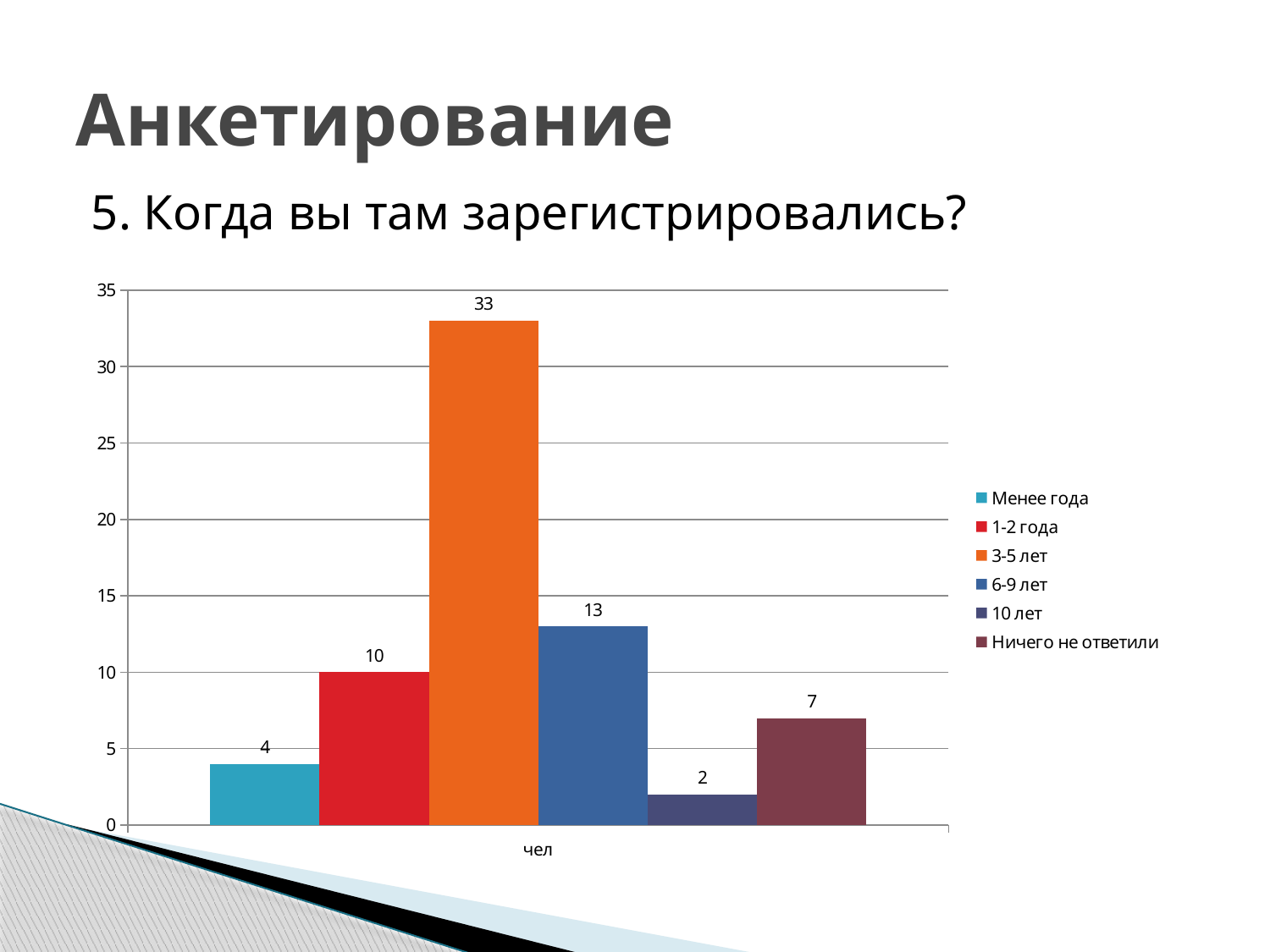
What is the value for "3-5 лет"? 33 Which is larger, the value for "6-9 лет" or the value for "1-2 года"? 6-9 лет Which series has the highest value? 3-5 лет How many series does the legend list? 6 What is the value for "Ничего не ответили"? 7 Which series has the lowest value? 10 лет Is the value for "6-9 лет" greater or less than 15? less What is the difference between the values for "3-5 лет" and "6-9 лет"? 20 What kind of chart is shown on the slide? bar chart What is the difference between the values for "1-2 года" and "Менее года"? 6 What is the label shown on the x axis of the chart? чел What is the value for "Менее года"? 4